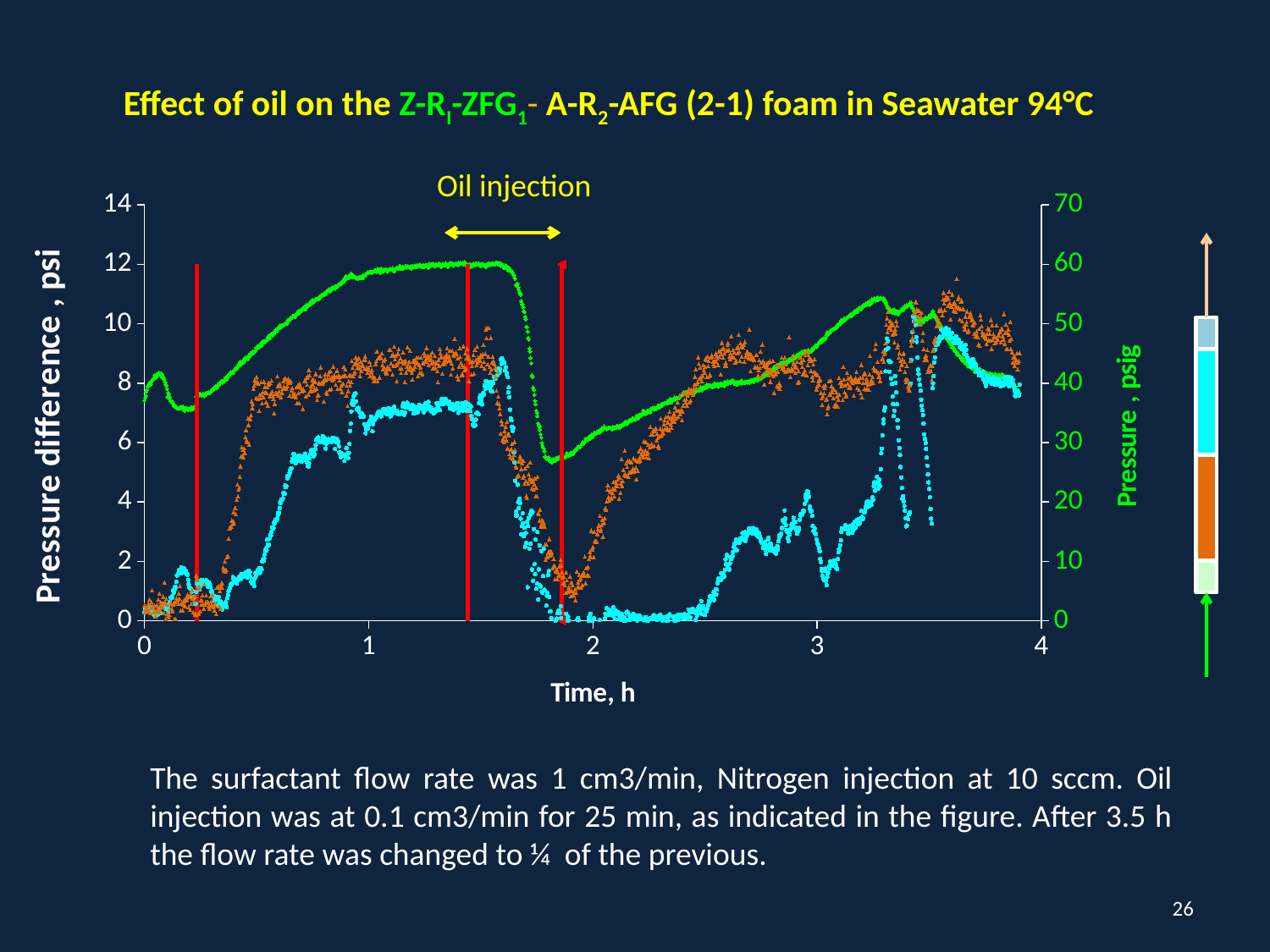
Is the green pressure series at time 1.5 h greater or less than 50 psig on the right axis? greater Is the orange pressure difference series at time 1 h greater or less than 6 psi? greater At time 1 h, which series shows the higher pressure difference, the orange or the cyan one? orange Does the green pressure series rise or fall between 0.3 h and 1.5 h? rise What is the label of the right-hand y axis of the chart? Pressure , psig What is the label of the x axis of the chart? Time, h Is the cyan pressure difference series at time 2.2 h greater or less than 2 psi? less Does the green pressure series rise or fall between 1.6 h and 1.85 h? fall What kind of chart is shown on the slide? scatter chart At time 3 h, which series shows the higher pressure difference, the orange or the cyan one? orange